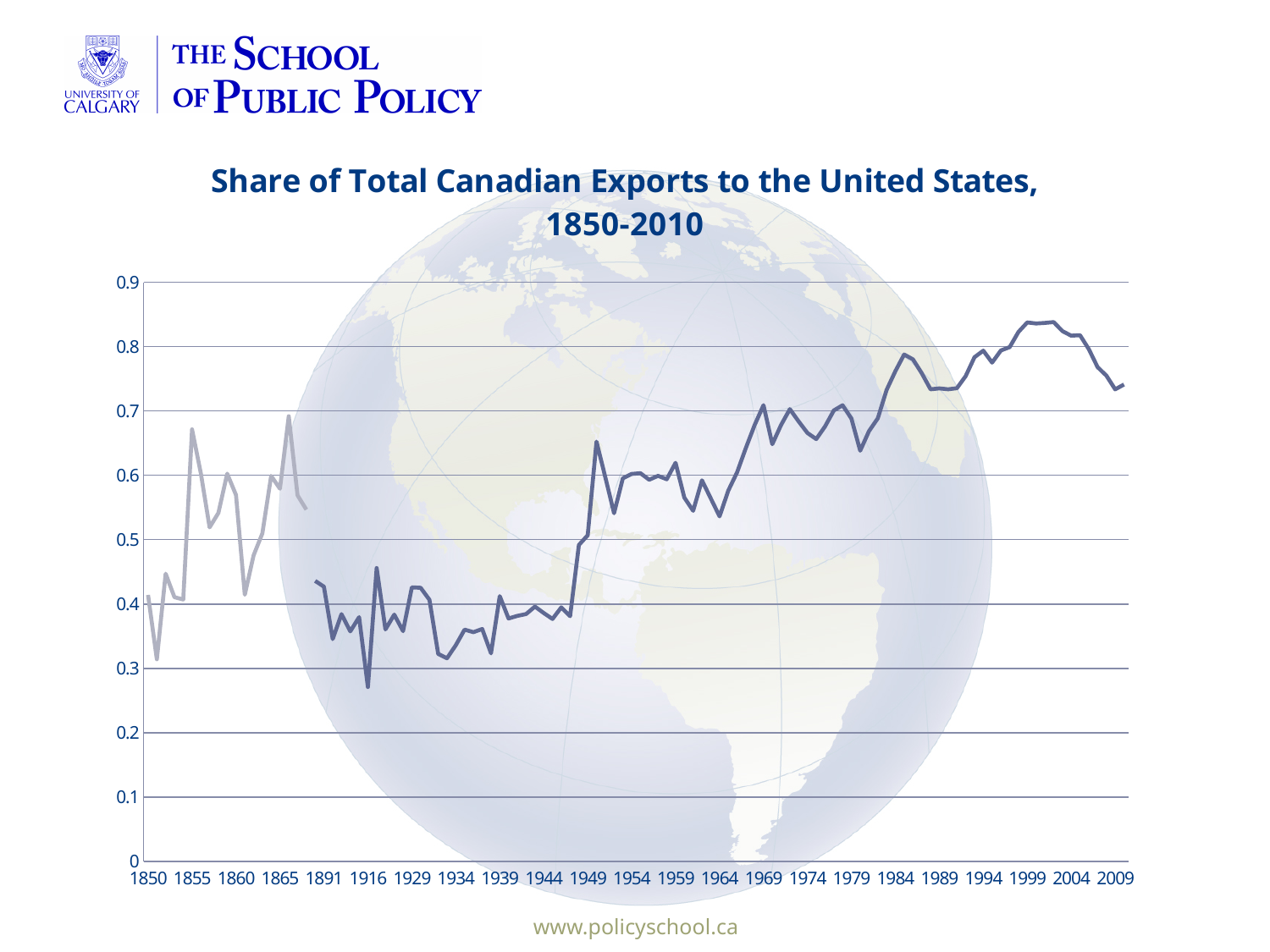
Does the share of exports to the United States generally rise or fall from 1850 to 2009? rise Is the value for 1916 greater or less than 0.3? less Is the value for 1999 greater or less than 0.8? greater What is the title of the chart? Share of Total Canadian Exports to the United States, 1850-2010 What is the highest value shown on the vertical axis? 0.9 How many year labels are shown on the horizontal axis? 23 Is the value for 1850 greater or less than 0.5? less What type of chart is shown on the slide? line chart Which is larger, the value for 2009 or the value for 1850? 2009